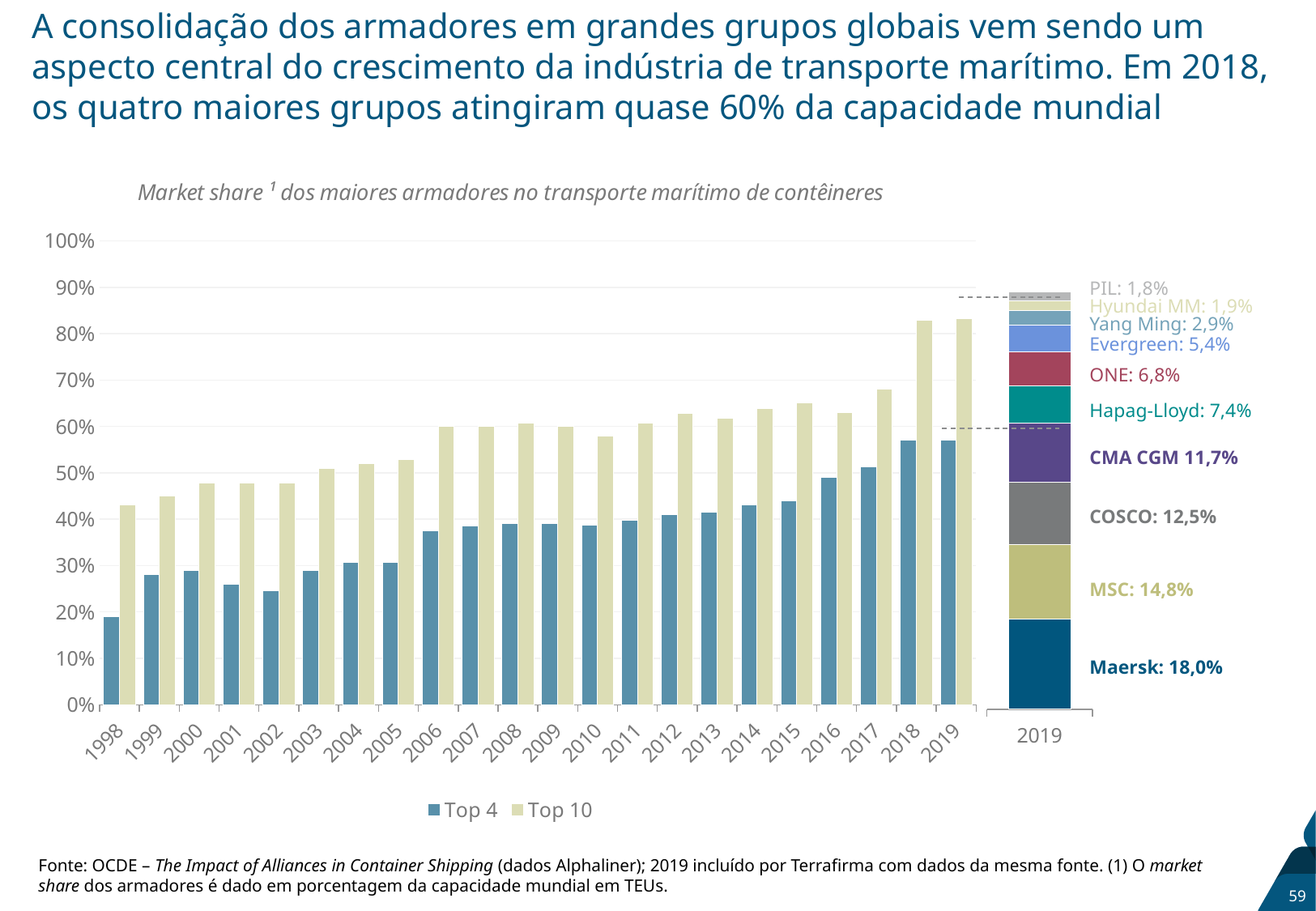
In the main chart, does the Top 4 market share generally rise or fall from 1998 to 2019? Rise In the 2019 stacked bar on the right, what is the difference between the market shares of Maersk and MSC? 3,2 percentage points In the main chart, is the Top 4 value for 1998 greater or less than 20%? less In the main chart, how many series does the legend list? 2 In the main chart, is the Top 10 value for 2018 greater or less than 80%? greater In the main chart, is the Top 4 value for 2002 greater or less than 30%? less In the main chart, what kind of chart is used to show the market share of the Top 4 and Top 10 carriers from 1998 to 2019? Bar chart In the 2019 stacked bar on the right, which carrier has the smallest market share? PIL In the 2019 stacked bar on the right, what is the market share of Maersk? 18,0% In the 2019 stacked bar on the right, what is the market share of Hapag-Lloyd? 7,4% In the main chart, how many years are shown on the x axis? 22 In the main chart, which year has the lowest Top 10 value? 1998